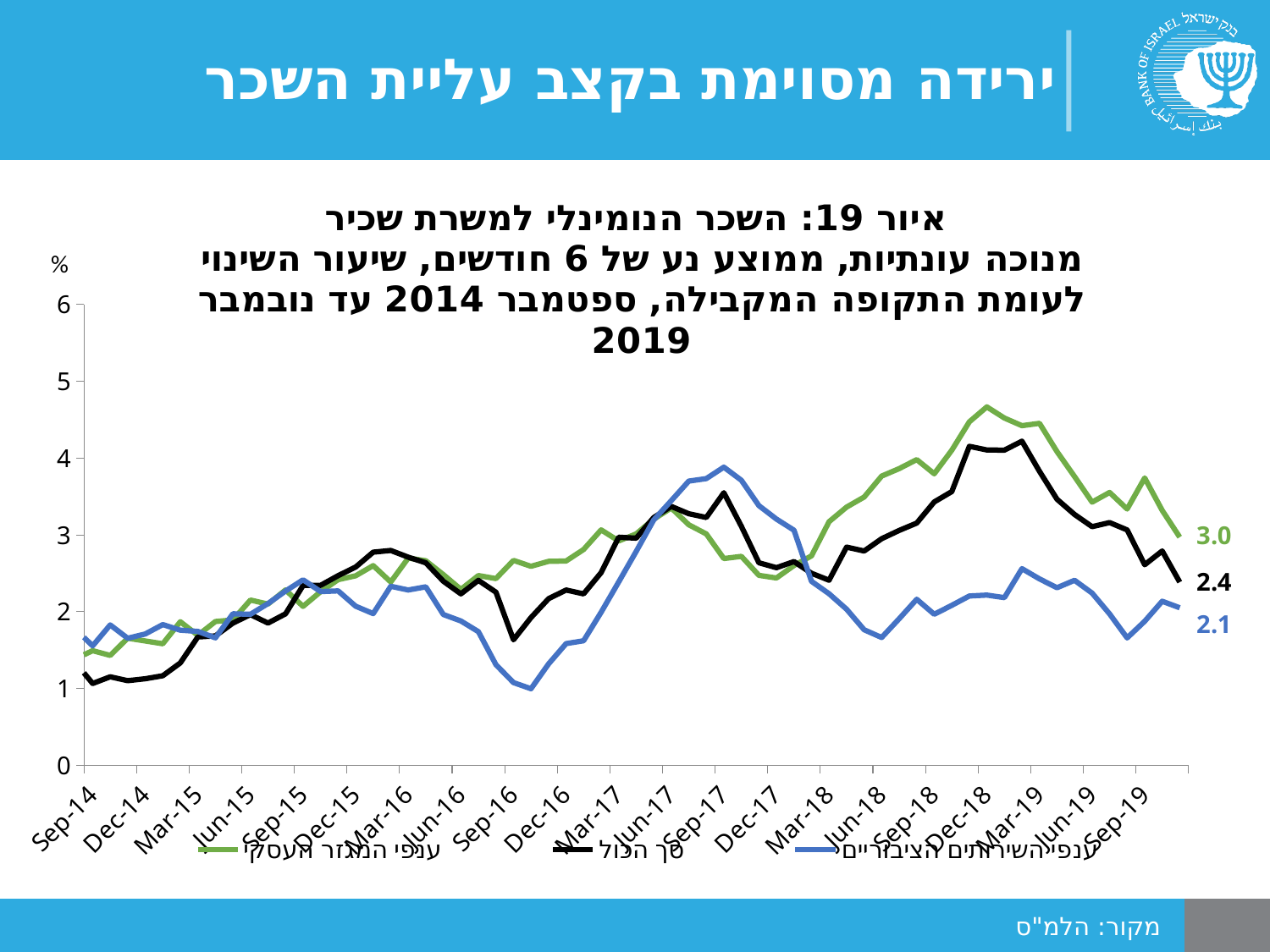
Which series has the lowest value at the end of the period? ענפי השירותים הציבוריים (public services) Is the value of the business sector (green) series around Dec-18 greater or less than 4? greater What is the difference between the final values of the business sector series (3.0) and the public services series (2.1)? 0.9 What kind of chart is shown on the slide? line chart What is the final labelled value of the public services series (ענפי השירותים הציבוריים, blue line)? 2.1 What is the final labelled value of the business sector series (ענפי המגזר העסקי, green line)? 3.0 What unit is shown on the y axis? % Which series has the highest value at the end of the period? ענפי המגזר העסקי (business sector) Is the value of the public services (blue) series around Sep-16 greater or less than 2? less What is the final labelled value of the total series (סך הכול, black line)? 2.4 How many series does the legend list? 3 At the end of the period, which is larger: the total series or the public services series? סך הכול (total)